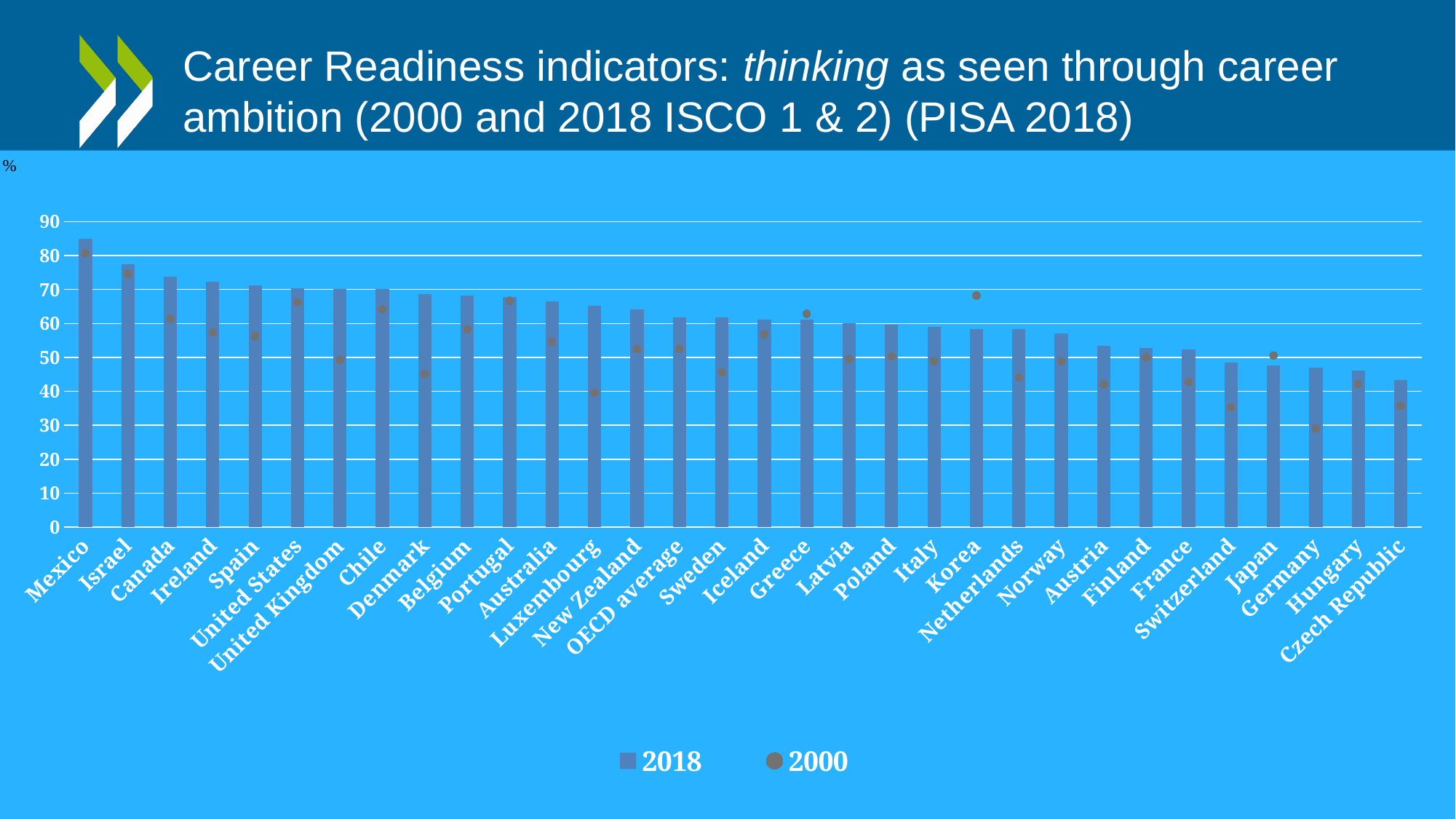
Is the 2000 value for Switzerland greater or less than 40? less How many countries/categories are shown on the x axis? 32 Which category has the lowest 2000 value? Germany How many series does the legend list? 2 For Korea, which is larger: the 2018 value or the 2000 value? 2000 Is the 2018 value for Mexico greater or less than 80? greater Do the 2018 bar values rise or fall moving from left to right along the x axis? fall What kind of chart is shown on the slide? bar chart Is the 2000 value for Korea greater or less than 60? greater Which series is shown as dots rather than bars? 2000 Which category has the highest 2018 value? Mexico Which category has the lowest 2018 value? Czech Republic